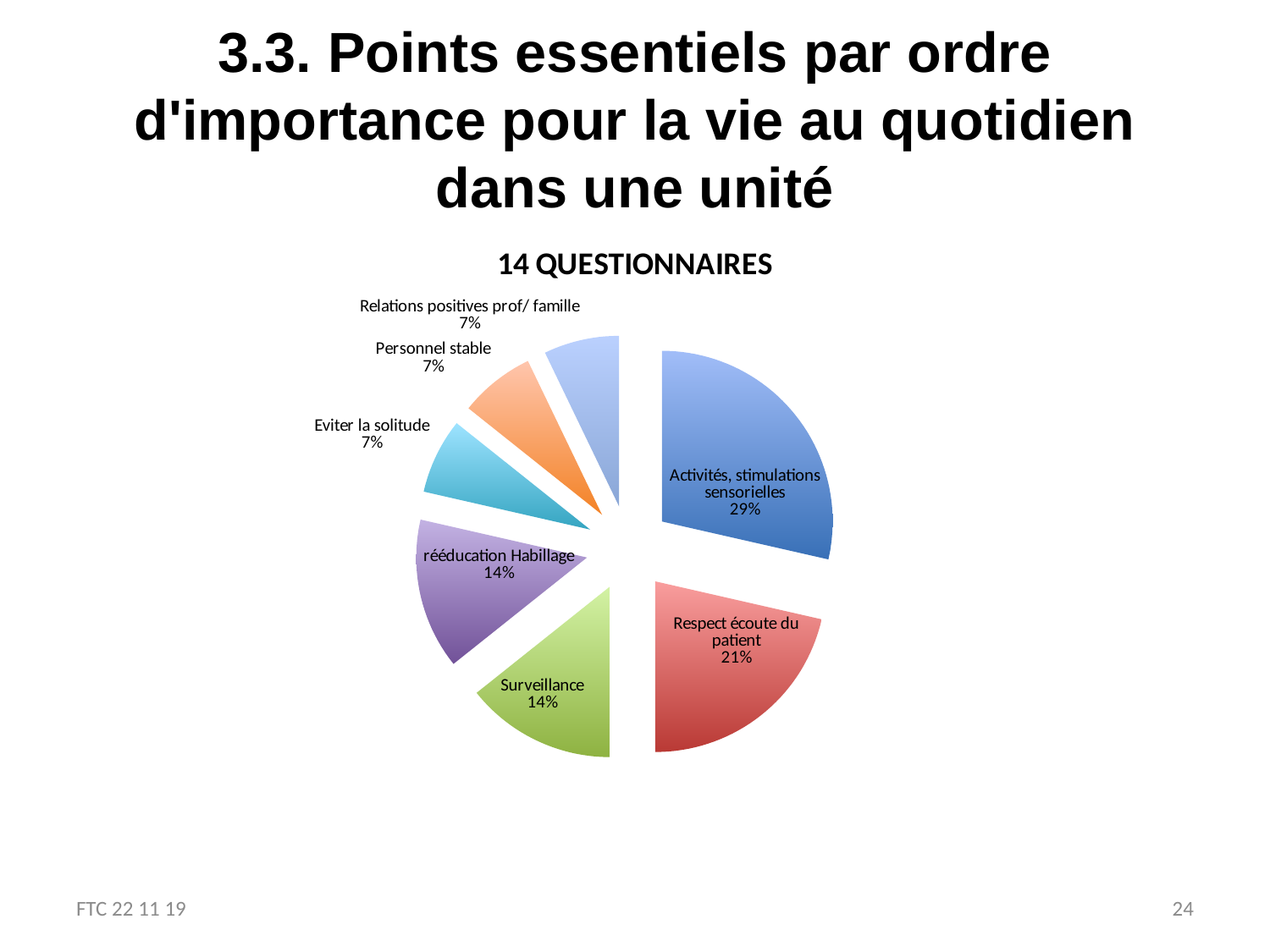
What is the difference in percentage points between "Activités, stimulations sensorielles" and "Respect écoute du patient"? 8 What share of the pie does "Respect écoute du patient" represent? 21% What is the value shown for "Surveillance"? 14% What is the value shown for "Personnel stable"? 7% What is the value shown for "rééducation Habillage"? 14% How many categories are shown with a value of 7%? 3 What kind of chart is shown on the slide? pie chart How many slices does the pie chart have? 7 What share of the pie does "Activités, stimulations sensorielles" represent? 29% What is the title of the chart? 14 QUESTIONNAIRES Which category has the largest slice of the pie? Activités, stimulations sensorielles Which is larger, the slice for "Respect écoute du patient" or the slice for "Surveillance"? Respect écoute du patient